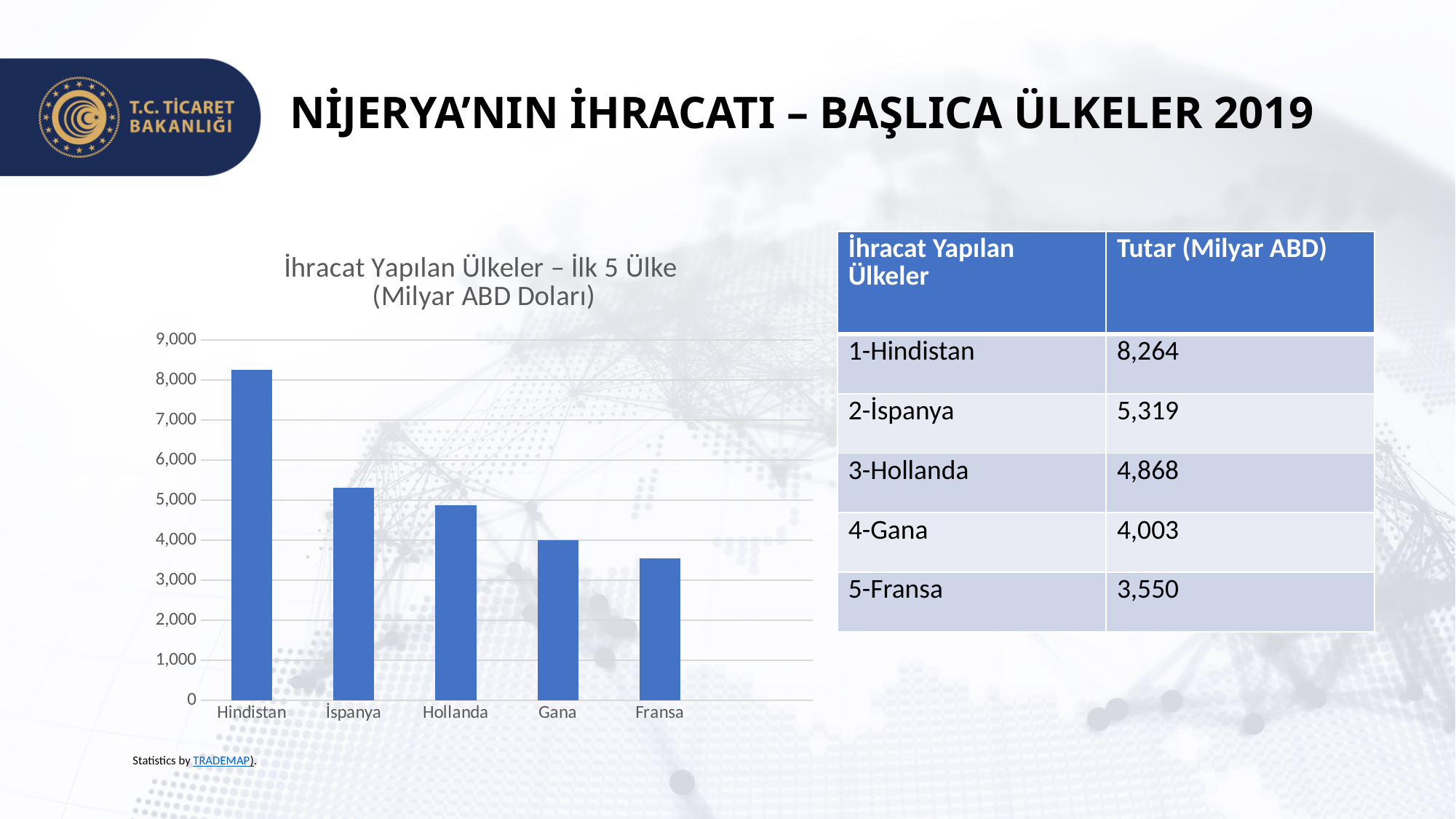
Which is larger, the value for Hollanda or the value for Fransa? Hollanda Which country has the highest bar in the chart? Hindistan What is the export value for Hindistan? 8,264 What is the title of the chart? İhracat Yapılan Ülkeler – İlk 5 Ülke (Milyar ABD Doları) Is the value for İspanya greater or less than 5,000? greater Which country has the lowest bar in the chart? Fransa How many countries are shown in the chart? 5 What kind of chart is shown on the slide? bar chart What is the export value for Gana? 4,003 What is the difference between the values for İspanya and Hollanda? 451 Is the value for Fransa greater or less than 4,000? less Do the bar values rise or fall from left to right along the x axis? fall